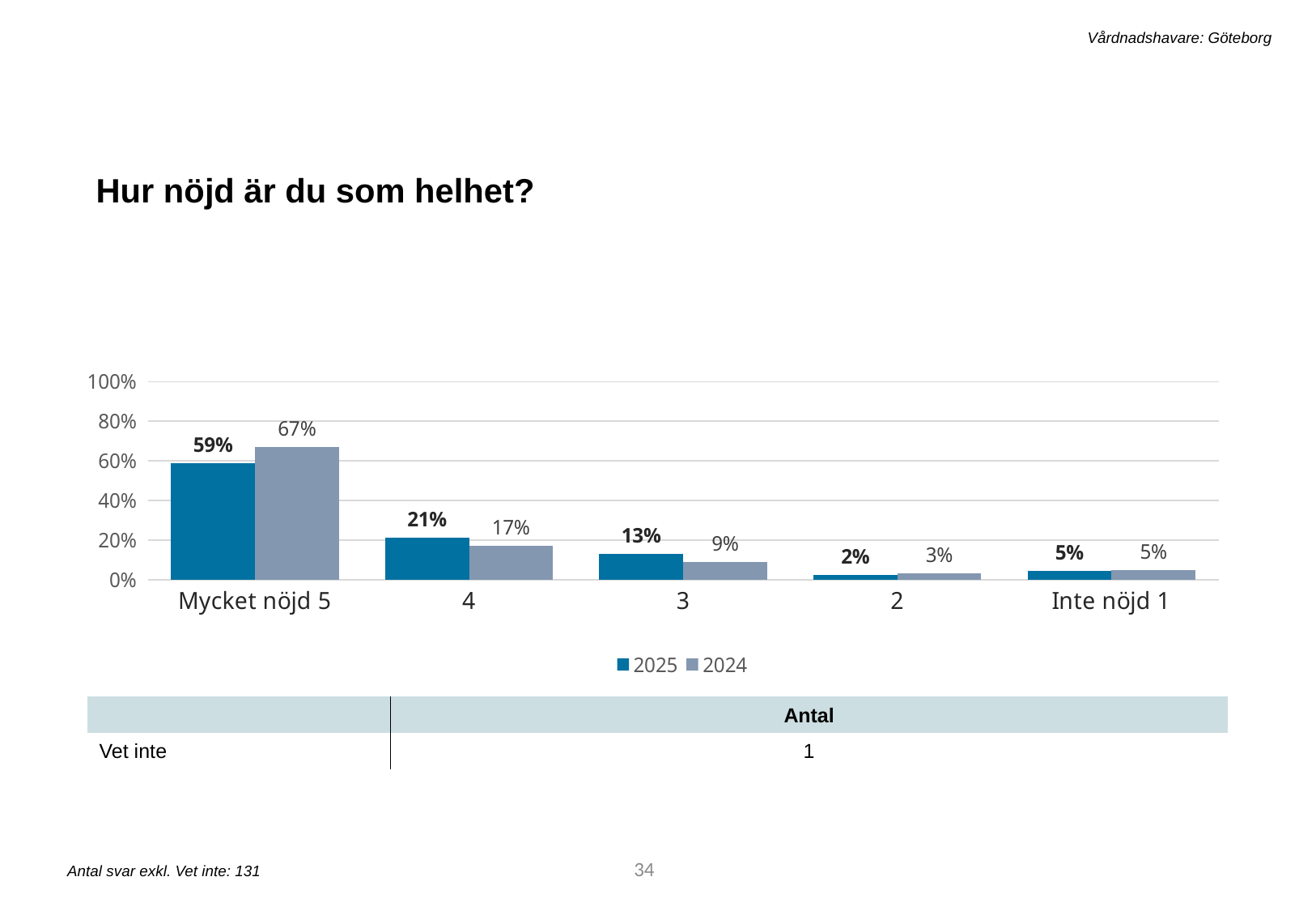
How many series does the legend list? 2 What is the 2024 value for "Mycket nöjd 5"? 67% Which category has the highest 2025 value? Mycket nöjd 5 What is the 2025 value for category "4"? 21% What is the 2025 value for "Inte nöjd 1"? 5% What kind of chart is shown on the slide? Bar chart What is the 2025 value for "Mycket nöjd 5"? 59% What is the difference between the 2024 and 2025 values for "Mycket nöjd 5"? 8% For category "4", which series has the larger value, 2025 or 2024? 2025 Which category has the lowest 2025 value? 2 How many categories are shown on the x axis? 5 What is the 2024 value for category "3"? 9%